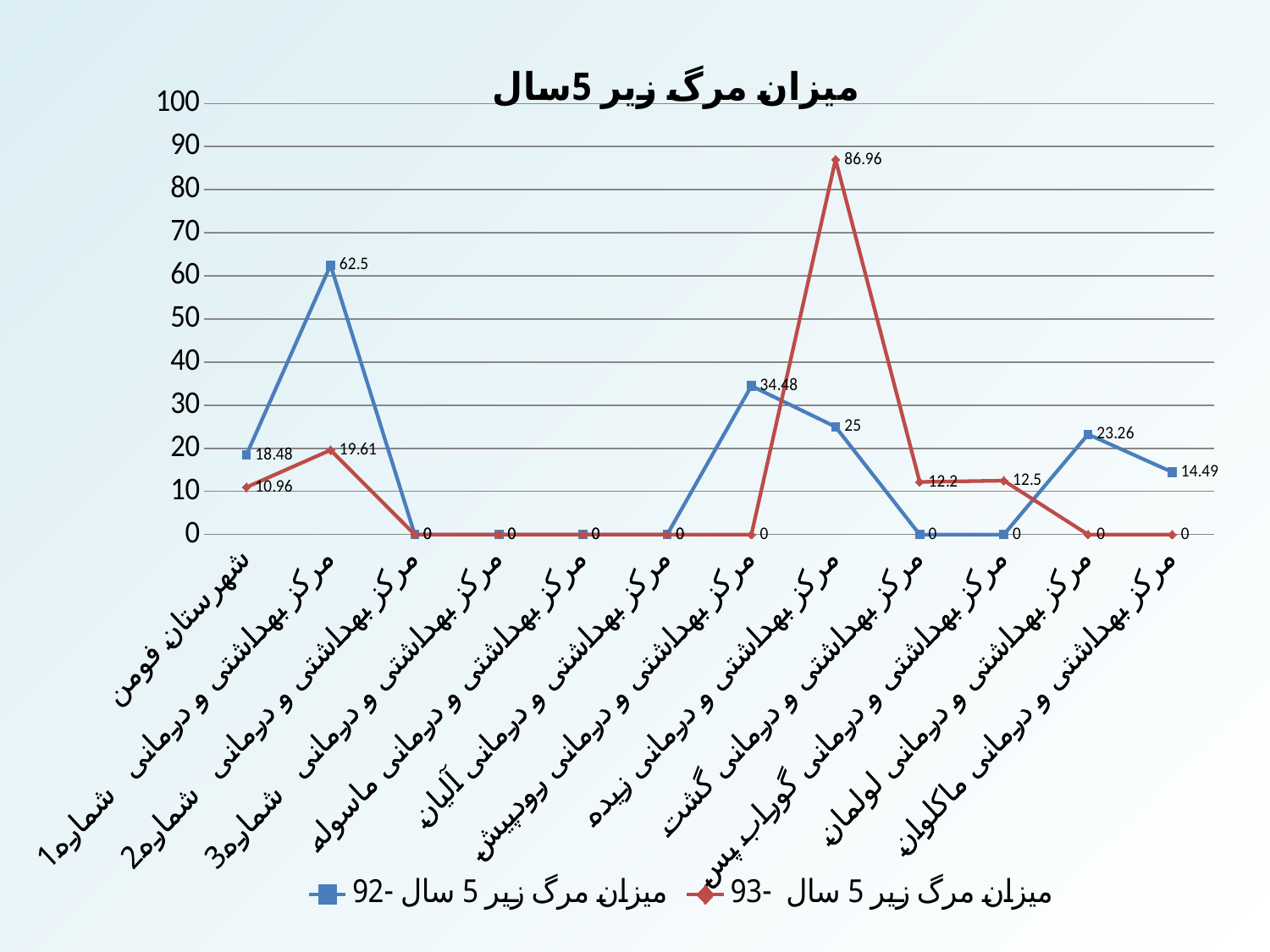
What is the value for مرکز بهداشتی و درمانی زیده in the series میزان مرگ زیر 5 سال -93? 86.96 What is the difference between the two series' values for مرکز بهداشتی و درمانی شماره2? 0 For مرکز بهداشتی و درمانی گوراب پس, which series has the larger value? میزان مرگ زیر 5 سال -93 What is the value for شهرستان فومن in the series میزان مرگ زیر 5 سال -92? 18.48 How many series does the legend list? 2 Which category has the highest value in the series میزان مرگ زیر 5 سال -93? مرکز بهداشتی و درمانی زیده What kind of chart is shown on the slide? line chart What is the title of the chart? میزان مرگ زیر 5سال Which category has the highest value in the series میزان مرگ زیر 5 سال -92? مرکز بهداشتی و درمانی شماره 1 How many categories are shown on the x axis? 12 What is the value for مرکز بهداشتی و درمانی گشت in the series میزان مرگ زیر 5 سال -93? 12.2 What is the value for مرکز بهداشتی و درمانی لولمان in the series میزان مرگ زیر 5 سال -92? 23.26